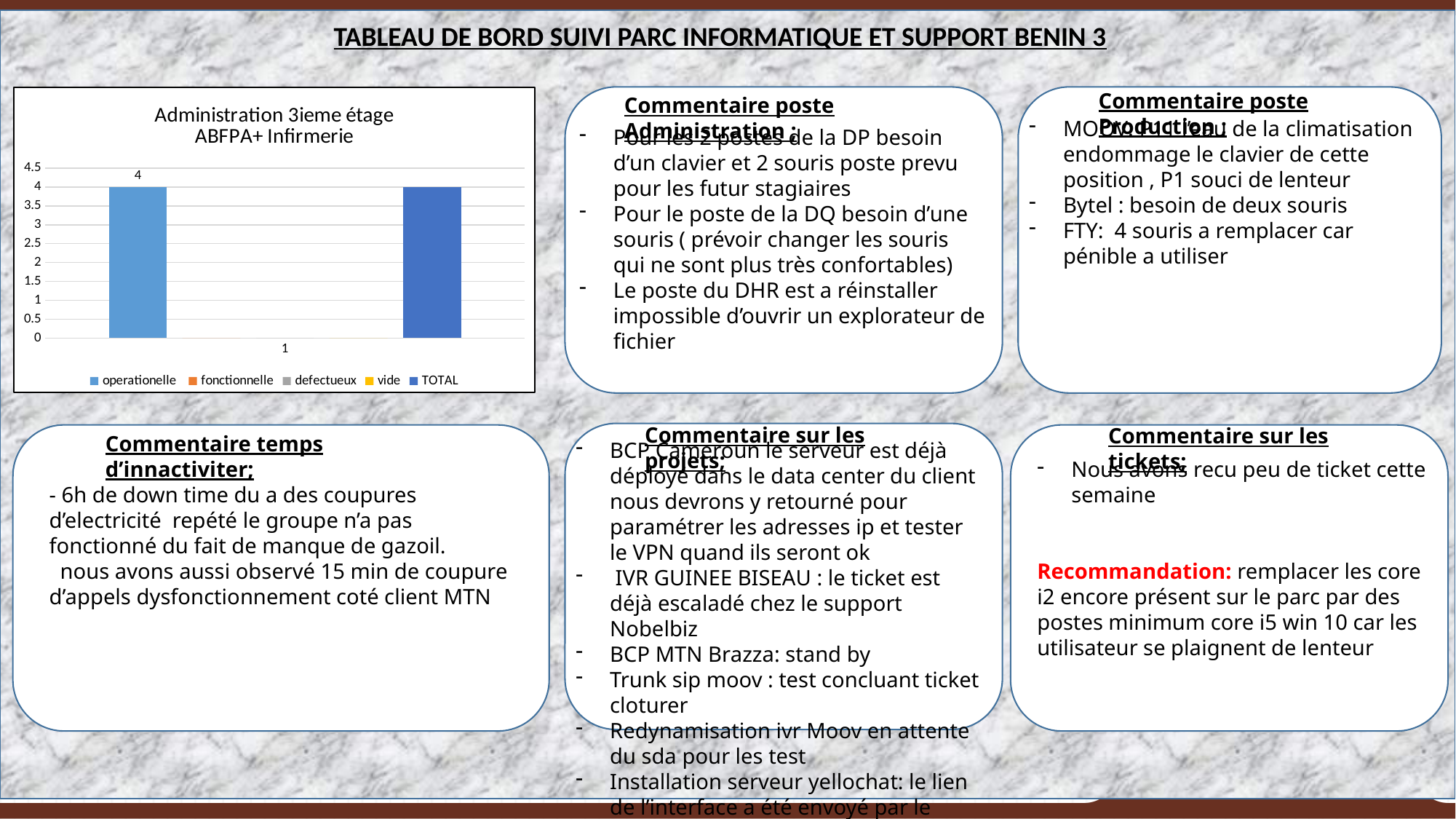
What kind of chart is shown on the slide? bar chart What is the highest value shown on the chart's y axis? 4.5 Which is larger in the chart, operationelle or fonctionnelle? operationelle Is the value of the operationelle bar greater or less than 3? greater What is the title of the chart? Administration 3ieme étage ABFPA+ Infirmerie How many categories are shown on the x axis of the chart? 1 Which legend series has the lowest visible bar, defectueux or operationelle? defectueux What value does the TOTAL bar reach on the axis? 4 What is the value of the operationelle bar in the chart? 4 Is the value of the TOTAL bar greater or less than 2? greater How many series does the chart legend list? 5